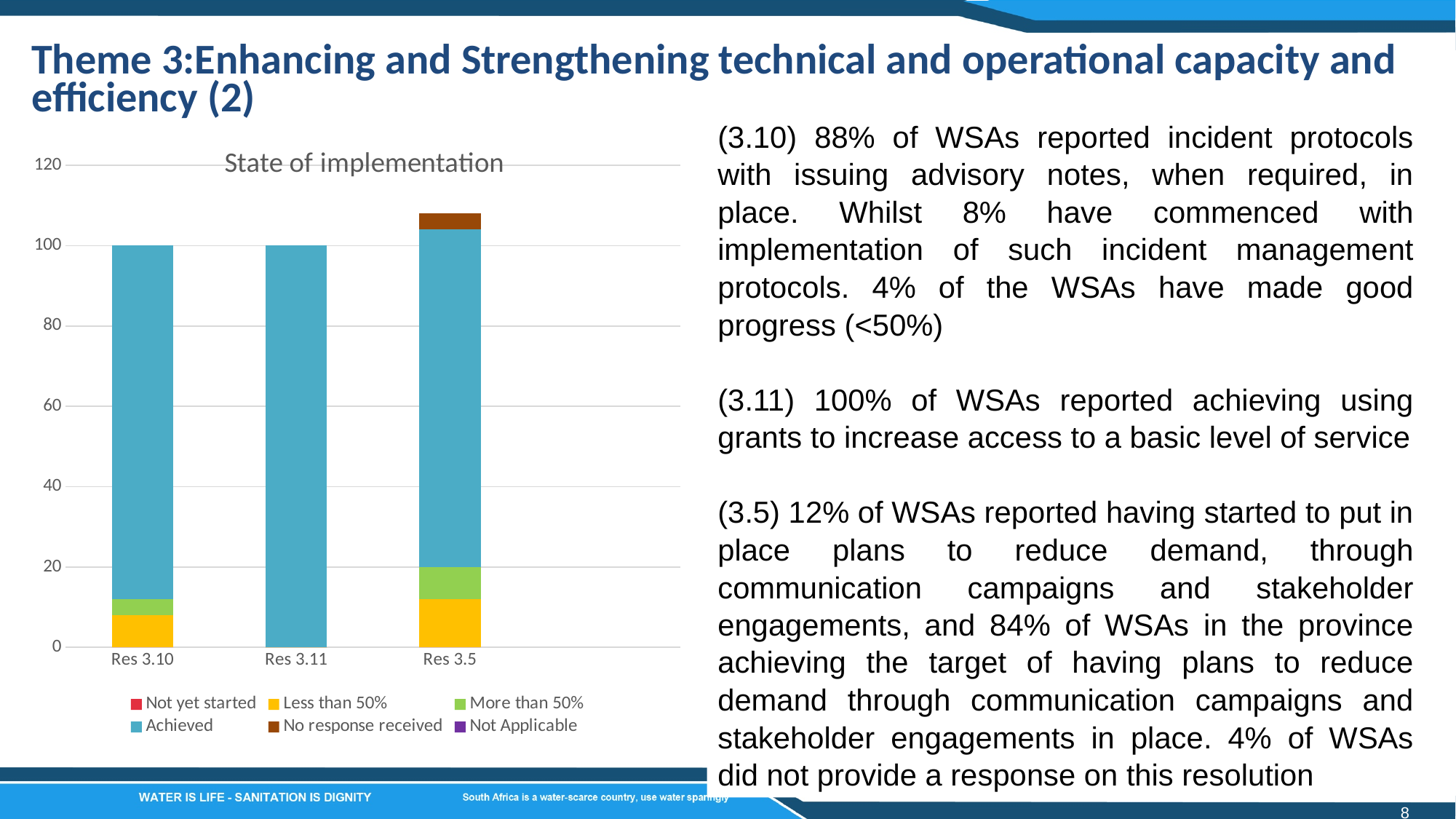
How many series does the chart legend list? 6 What is the total height of the stacked bar for Res 3.11? 100 What is the title of the chart? State of implementation Is the 'No response received' value for Res 3.5 greater or less than 20? less Is the 'Less than 50%' value for Res 3.10 greater or less than 20? less Which category has a larger 'Less than 50%' segment, Res 3.10 or Res 3.5? Res 3.5 Which category's bar consists only of the 'Achieved' series? Res 3.11 What kind of chart is shown on the slide? Stacked bar chart Which category has the tallest stacked bar in the chart? Res 3.5 Is the 'Achieved' value for Res 3.5 greater or less than 60? greater How many categories are shown on the x axis of the chart? 3